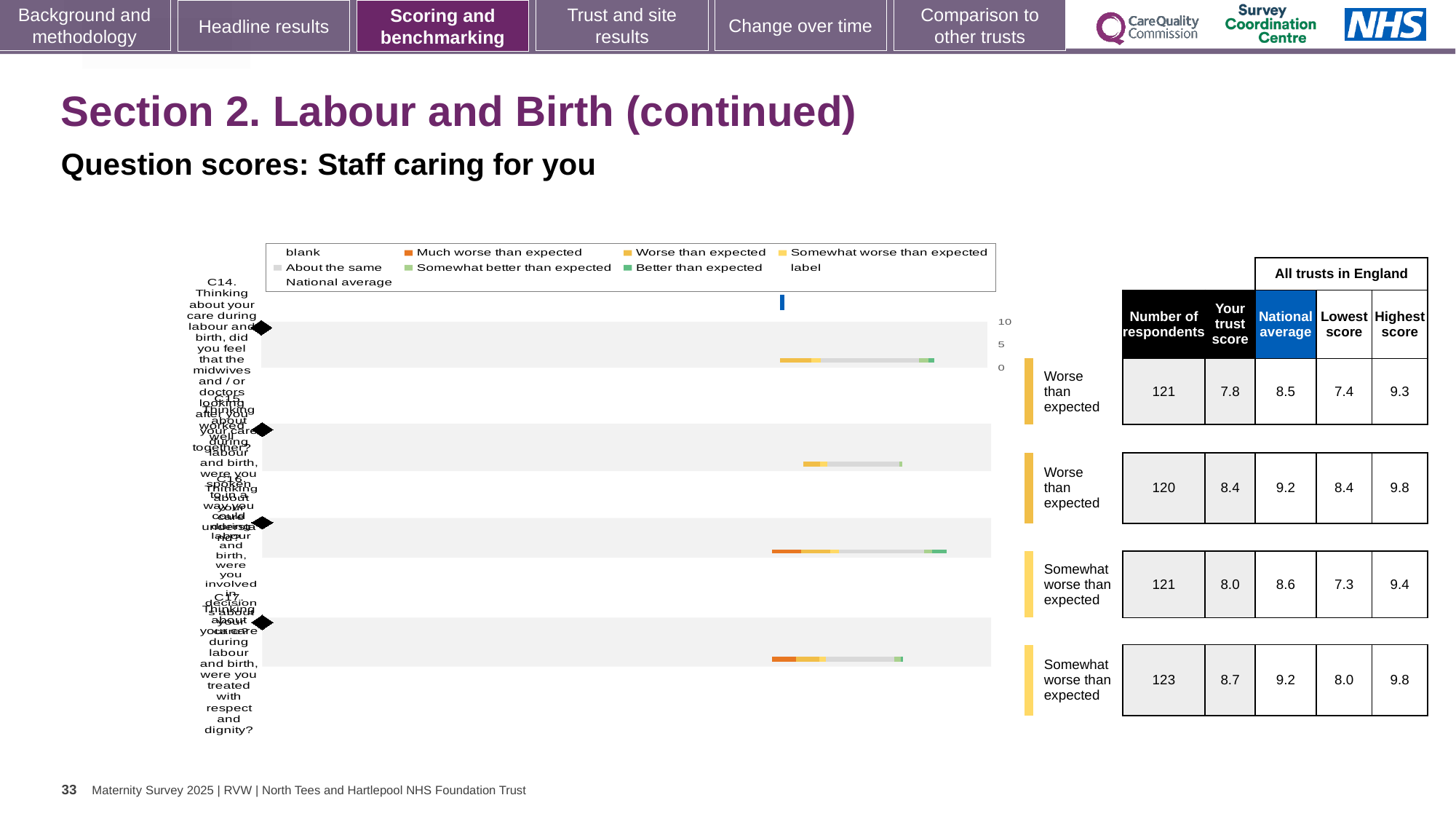
In the chart legend, what colour represents 'Better than expected'? green In the table beside the chart, how many respondents are listed for the last row (C17)? 123 How many question rows (categories) does the chart show? 4 What is the highest tick value shown on the chart's axis? 10 In the table beside the chart, what is the national average for the second row (C15)? 9.2 What benchmark label is given for the third row (C16)? Somewhat worse than expected In the table beside the chart, what is the highest score for the third row (C16)? 9.4 For the first row (C14), what is the difference between the national average and the trust score? 0.7 Which row has the highest 'Your trust score' in the table beside the chart? C17 (8.7) Which is larger: the trust score for C17 or the trust score for C14? C17 What kind of chart is shown on the slide? bar chart In the table beside the chart, what is the 'Your trust score' for the first row (C14)? 7.8